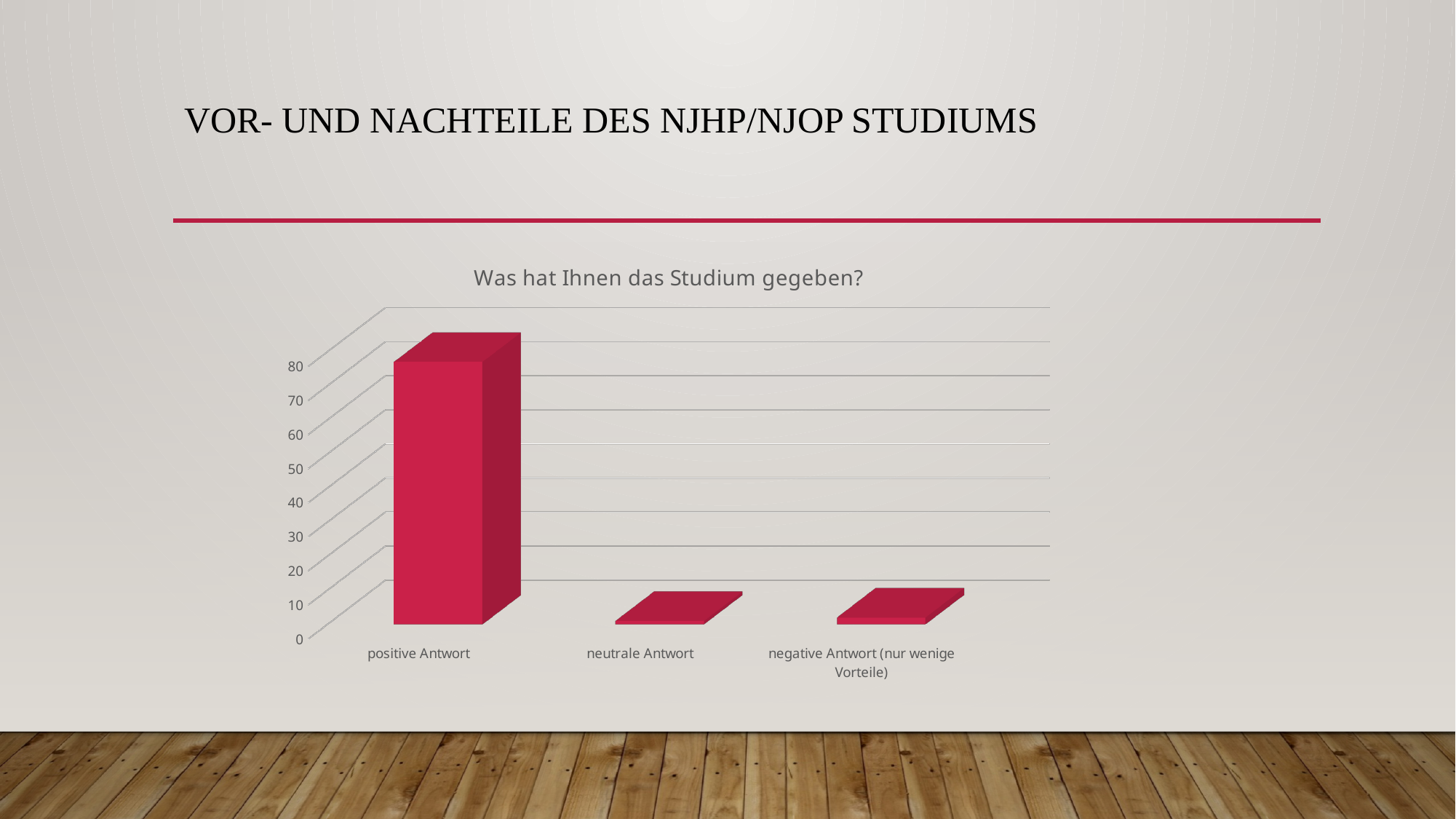
Is the value for negative Antwort (nur wenige Vorteile) greater or less than 10? less How many categories are shown on the x axis of the chart? 3 Is the value for positive Antwort greater or less than 60? greater Do the values generally rise or fall from left to right along the x axis? fall What is the title of the chart? Was hat Ihnen das Studium gegeben? Is the value for neutrale Antwort greater or less than 10? less Which category has the highest value? positive Antwort What kind of chart is shown on the slide? bar chart Which is larger, the value for positive Antwort or the value for negative Antwort (nur wenige Vorteile)? positive Antwort What is the highest value labelled on the vertical axis of the chart? 80 Which is larger, the value for positive Antwort or the value for neutrale Antwort? positive Antwort